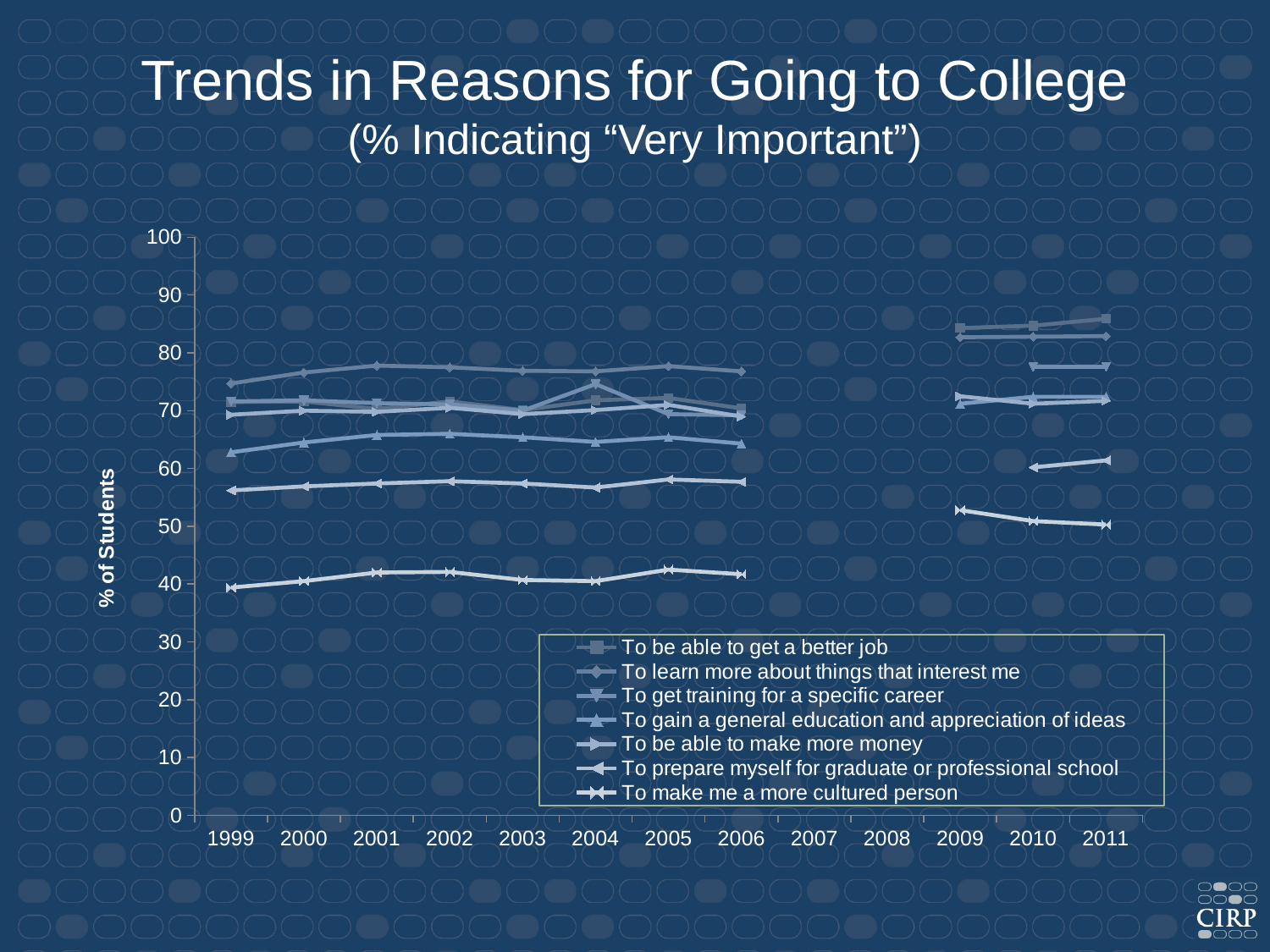
Is the value for "To learn more about things that interest me" in 1999 greater or less than 70? greater Is the value for "To prepare myself for graduate or professional school" in 1999 greater or less than 60? less Which reason has the lowest value in 2011? To make me a more cultured person How many years are labelled on the x axis? 13 How many series does the legend list? 7 Which reason has the highest value in 2011? To be able to get a better job What is the label on the y axis? % of Students Is the value for "To make me a more cultured person" in 2009 greater or less than 50? greater What is the title of the chart? Trends in Reasons for Going to College (% Indicating "Very Important") What kind of chart is shown on the slide? Line chart Does the value for "To be able to get a better job" rise or fall from 1999 to 2011? rise